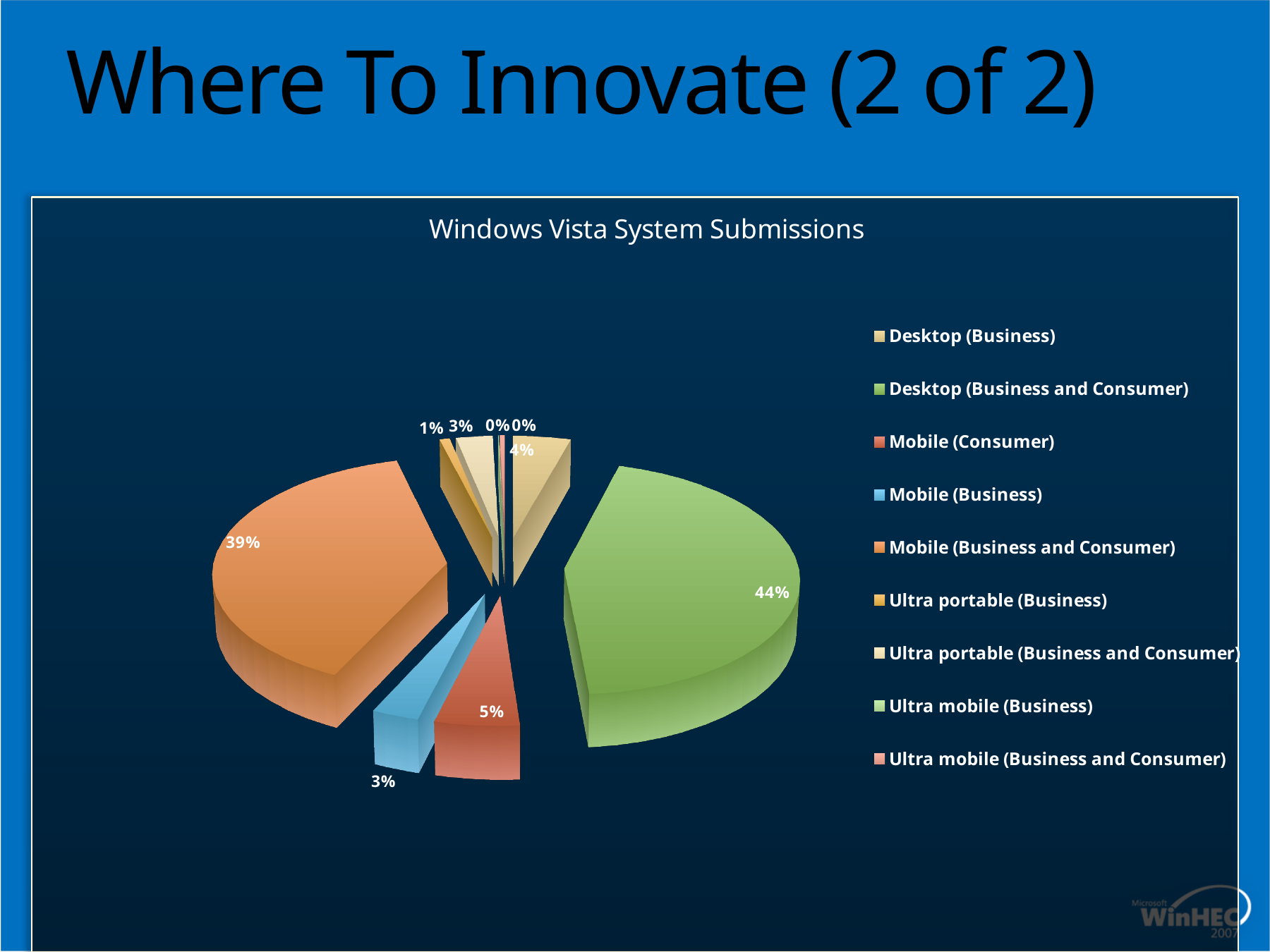
What colour is the slice for Desktop (Business and Consumer)? green What share of submissions is Desktop (Business and Consumer)? 44% What type of chart is shown on the slide? pie chart What share of submissions is Mobile (Consumer)? 5% What share of submissions is Desktop (Business)? 4% What is the title of the chart? Windows Vista System Submissions What is the difference in share between Desktop (Business and Consumer) and Mobile (Business and Consumer)? 5% Which category has the largest share of submissions? Desktop (Business and Consumer) Which has a larger share, Mobile (Consumer) or Mobile (Business)? Mobile (Consumer) What share of submissions is Mobile (Business)? 3% What share of submissions is Mobile (Business and Consumer)? 39% How many categories does the legend list? 9